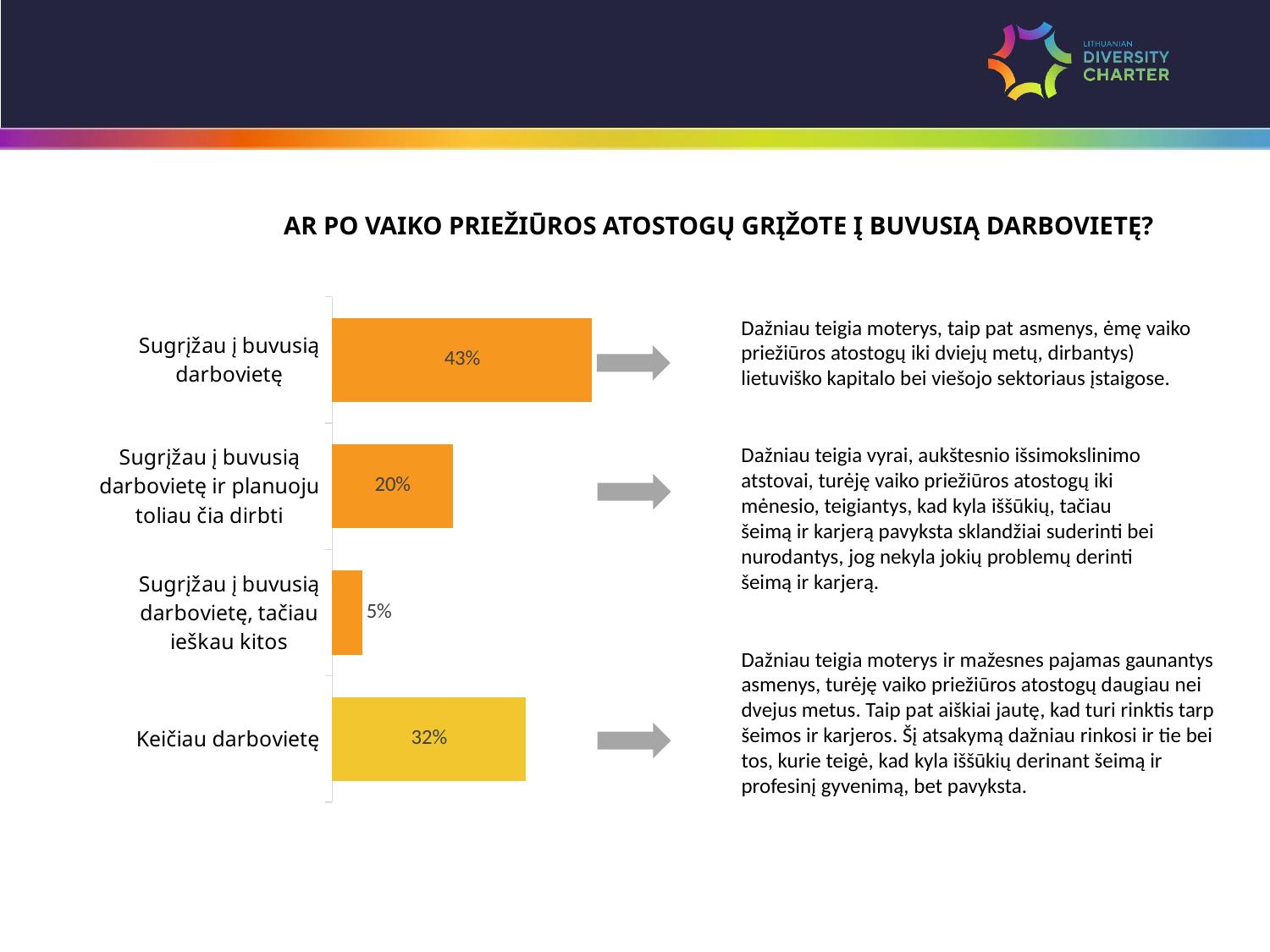
What is the value for "Keičiau darbovietę"? 32% How many categories does the chart show? 4 What kind of chart is shown on the slide? Bar chart Which category has the lowest value? Sugrįžau į buvusią darbovietę, tačiau ieškau kitos What is the value for "Sugrįžau į buvusią darbovietę ir planuoju toliau čia dirbti"? 20% What is the value for "Sugrįžau į buvusią darbovietę, tačiau ieškau kitos"? 5% What is the difference between the values for "Sugrįžau į buvusią darbovietę ir planuoju toliau čia dirbti" and "Sugrįžau į buvusią darbovietę, tačiau ieškau kitos"? 15% Which category has the highest value? Sugrįžau į buvusią darbovietę What is the title of the chart? AR PO VAIKO PRIEŽIŪROS ATOSTOGŲ GRĮŽOTE Į BUVUSIĄ DARBOVIETĘ? What is the value for "Sugrįžau į buvusią darbovietę"? 43% Which is larger: the value for "Keičiau darbovietę" or the value for "Sugrįžau į buvusią darbovietę ir planuoju toliau čia dirbti"? Keičiau darbovietę What is the difference between the values for "Sugrįžau į buvusią darbovietę" and "Keičiau darbovietę"? 11%